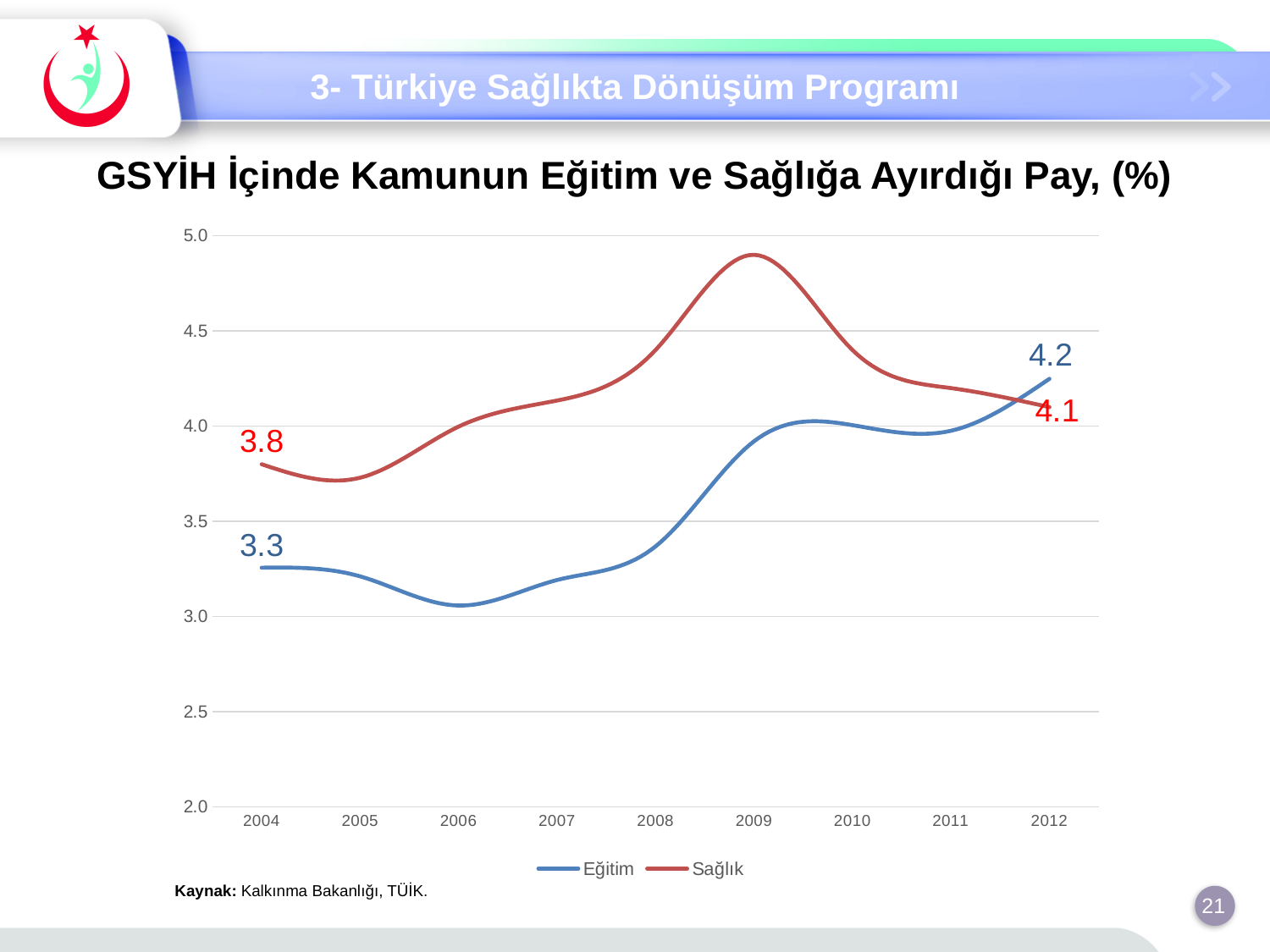
In which year does the Eğitim line reach its lowest point? 2006 What is the difference between the Sağlık and Eğitim values in 2004? 0.5 What is the value for Eğitim in 2012? 4.2 What is the value for Sağlık in 2012? 4.1 By how much did the Eğitim value increase from 2004 to 2012? 0.9 How many series does the legend list? 2 What is the value for Eğitim in 2004? 3.3 What kind of chart is shown on the slide? Line chart Is the value for Sağlık in 2009 greater or less than 4.5? greater How many years are shown on the x axis? 9 Which series has the higher value in 2012, Eğitim or Sağlık? Eğitim In which year does the Sağlık line reach its highest point? 2009